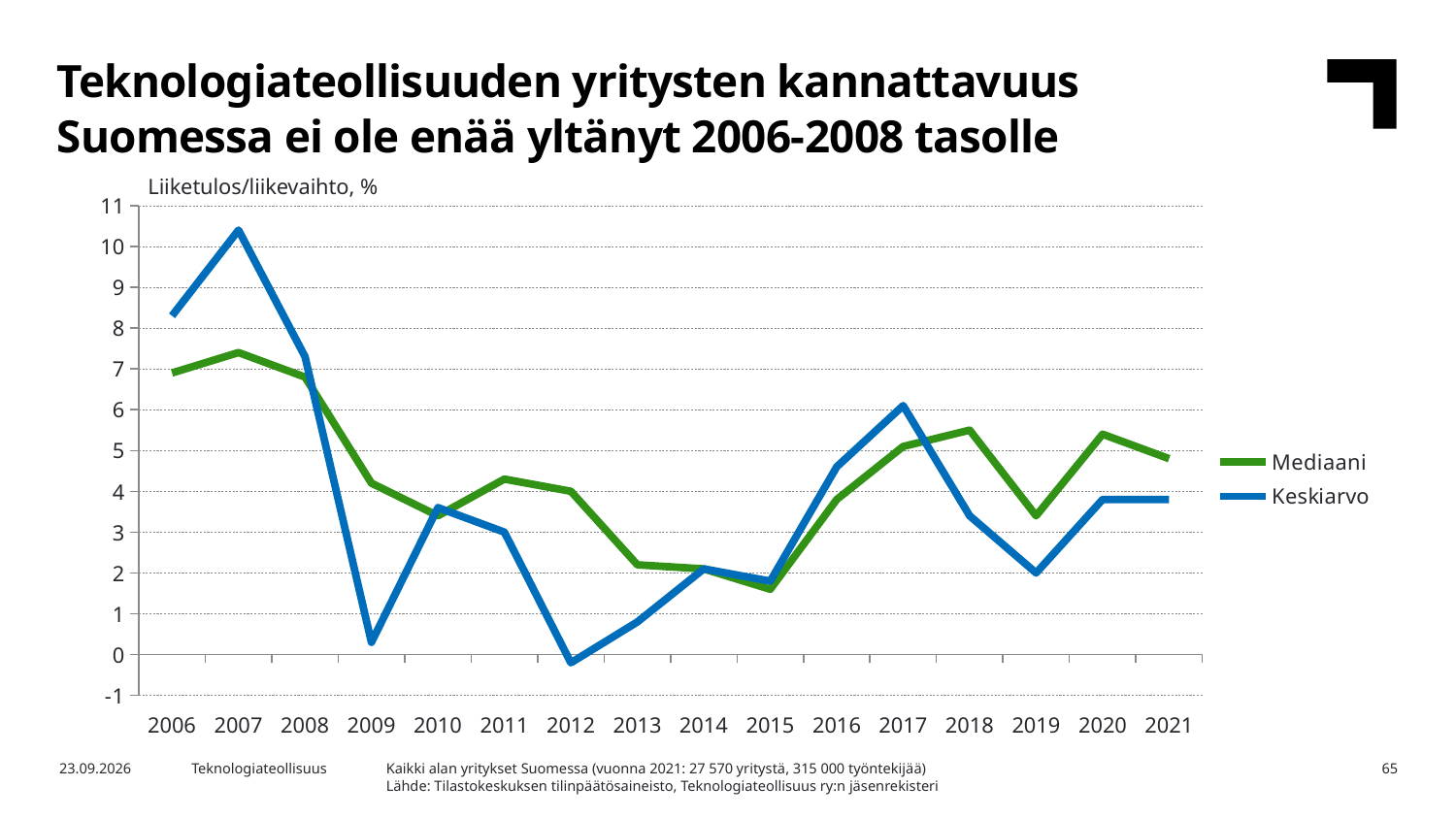
Is the Keskiarvo value for 2009 greater or less than 1? less What is the label shown above the y axis of the chart? Liiketulos/liikevaihto, % Is the Mediaani value for 2020 greater or less than 5? greater How many years are shown on the x axis? 16 Does the Keskiarvo series rise or fall from 2007 to 2009? fall In which year does the Keskiarvo series reach its highest value? 2007 How many series does the legend list? 2 What kind of chart is shown on the slide? line chart In which year does the Keskiarvo series reach its lowest value? 2012 In 2012, which series has the larger value, Mediaani or Keskiarvo? Mediaani Is the Mediaani value for 2006 greater or less than 6? greater In which year does the Mediaani series reach its lowest value? 2015